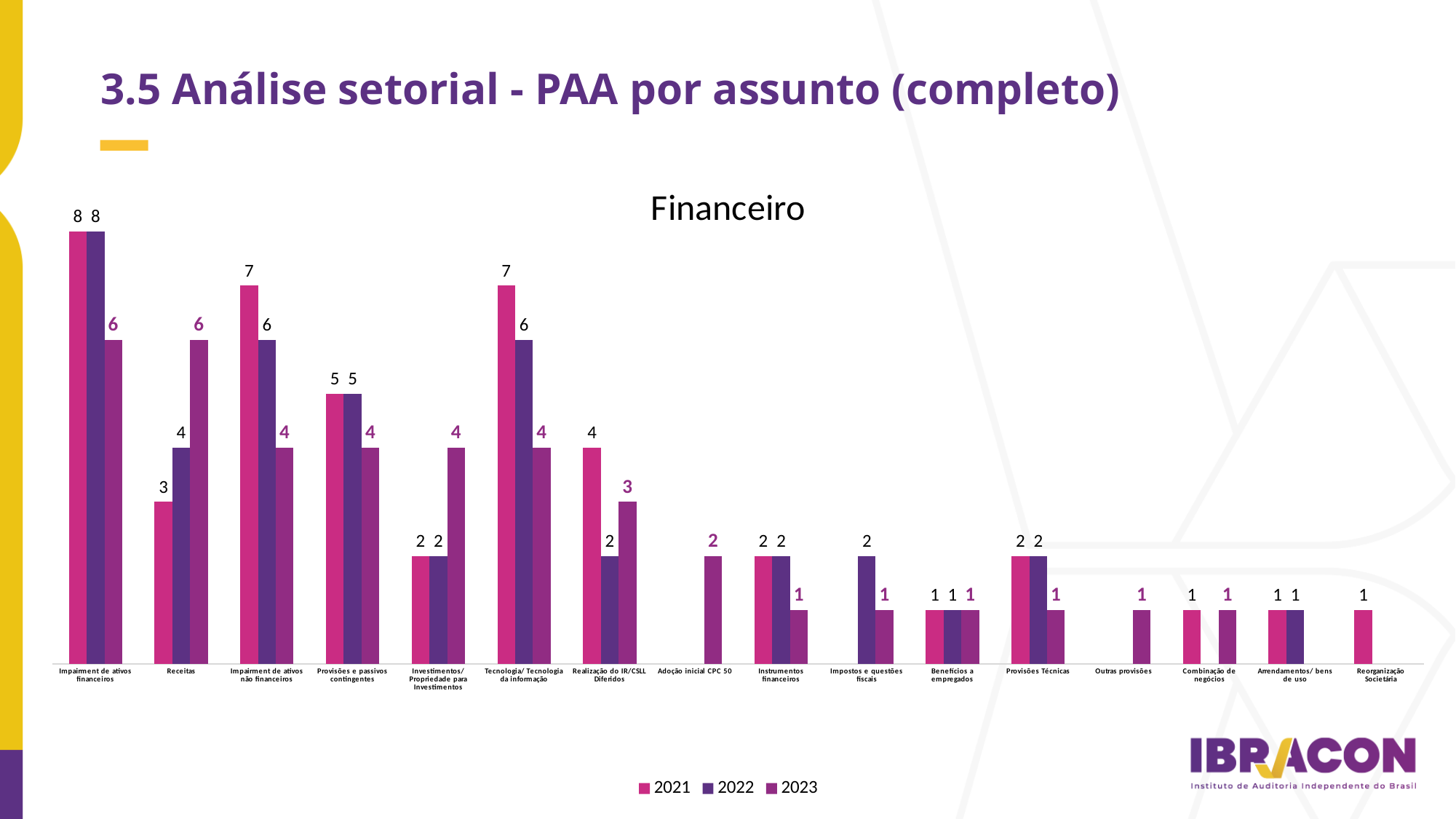
How many categories are shown on the x axis? 16 For Receitas, which is larger: the 2021 value or the 2023 value? 2023 What is the 2023 value for Receitas? 6 What is the 2021 value for Tecnologia/ Tecnologia da informação? 7 Do the values for Impairment de ativos não financeiros rise or fall from 2021 to 2023? Fall What is the 2022 value for Impostos e questões fiscais? 2 Which category has the highest 2021 value? Impairment de ativos financeiros What is the difference between the 2021 and 2023 values for Impairment de ativos não financeiros? 3 What is the title of the chart? Financeiro What kind of chart is shown on the slide? Bar chart How many series does the legend list? 3 Which category has the highest 2023 value? Impairment de ativos financeiros and Receitas (tied at 6)